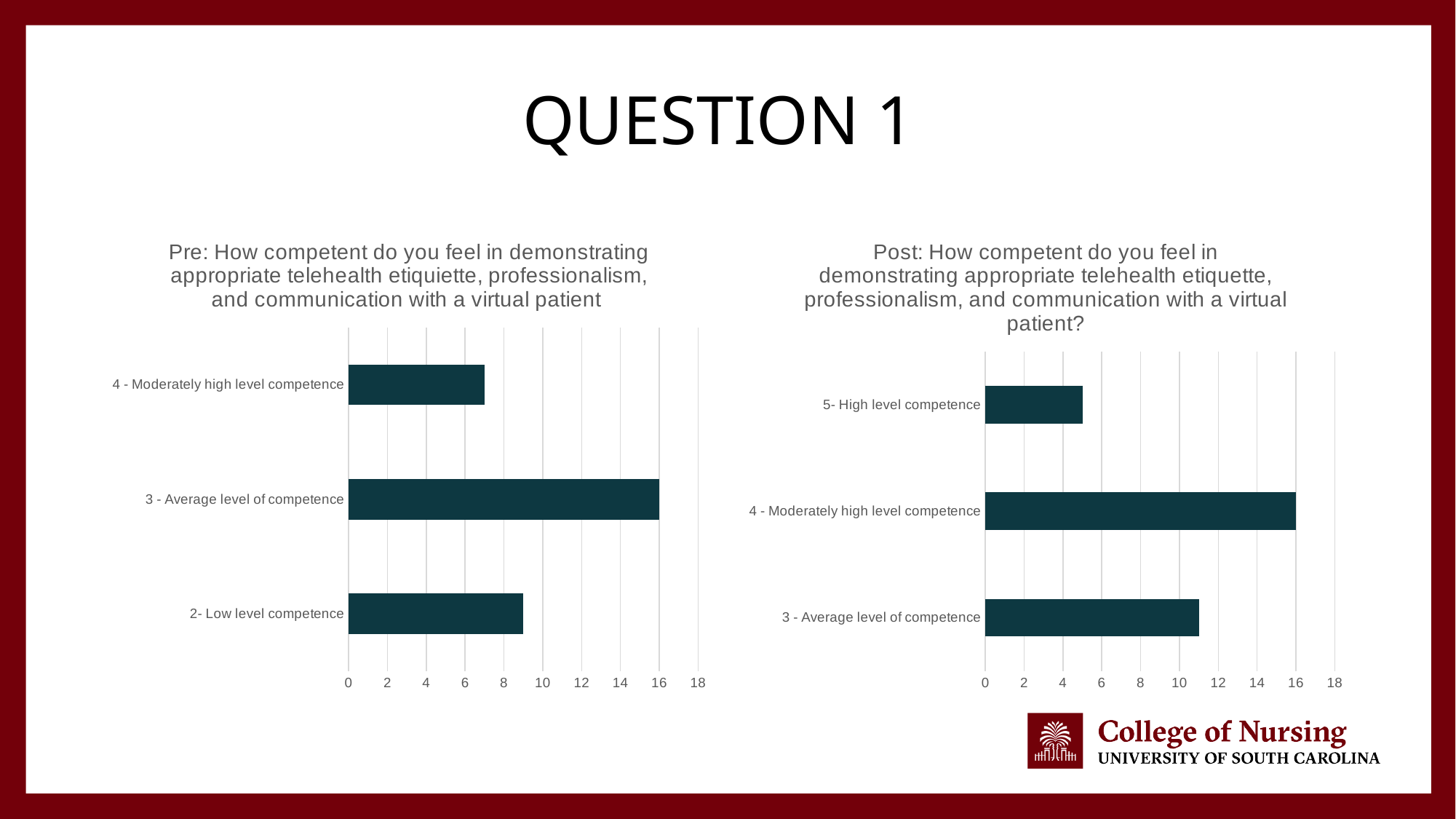
In the Pre chart on the left, which category has the lowest value? 4 - Moderately high level competence In the Pre chart on the left, is the value for 2- Low level competence greater or less than 8? greater In the Post chart on the right, is the value for 5- High level competence greater or less than 6? less How many categories are shown in the Post chart on the right? 3 In the Post chart on the right, which category has the highest value? 4 - Moderately high level competence In the Pre chart on the left, which is larger: the value for 2- Low level competence or the value for 4 - Moderately high level competence? 2- Low level competence In the Post chart on the right, what is the value for 4 - Moderately high level competence? 16 In the Post chart on the right, which category has the lowest value? 5- High level competence In the Post chart on the right, is the value for 3 - Average level of competence greater or less than 10? greater In the Pre chart on the left, what is the value for 3 - Average level of competence? 16 In the Pre chart on the left, which category has the highest value? 3 - Average level of competence What kind of chart is the Pre chart on the left? Bar chart